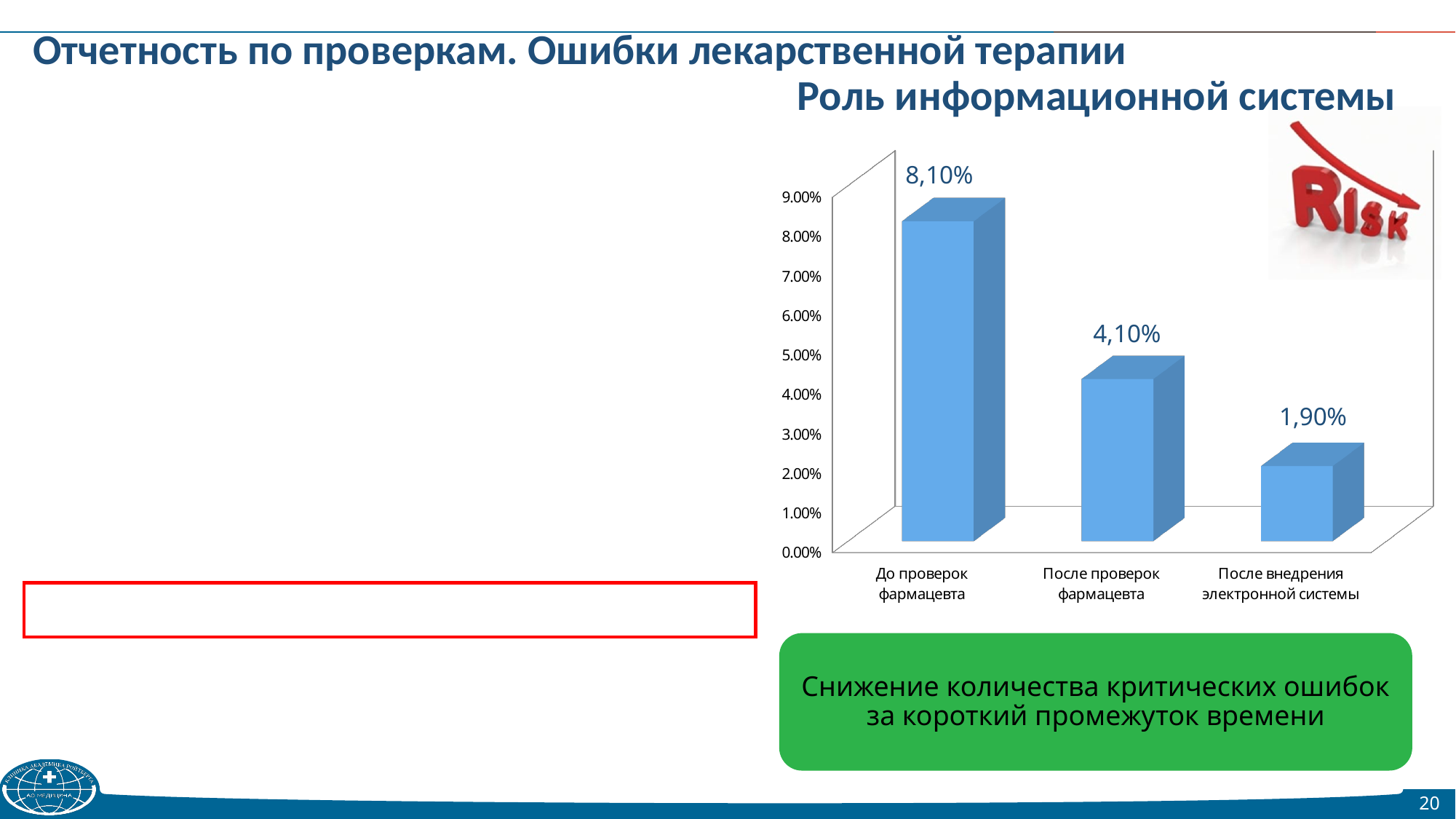
What is the value for "До проверок фармацевта"? 8,10% What is the value for "После внедрения электронной системы"? 1,90% What is the difference between the values for "До проверок фармацевта" and "После проверок фармацевта"? 4,00% Which is larger: the value for "После проверок фармацевта" or for "После внедрения электронной системы"? После проверок фармацевта What kind of chart is shown on the slide? Bar chart How many categories are shown on the chart? 3 Is the value for "До проверок фармацевта" greater or less than 7.00%? greater Which category has the lowest value? После внедрения электронной системы What is the value for "После проверок фармацевта"? 4,10% Which category has the highest value? До проверок фармацевта Do the values rise or fall from left to right along the x axis? Fall What is the difference between the values for "После проверок фармацевта" and "После внедрения электронной системы"? 2,20%